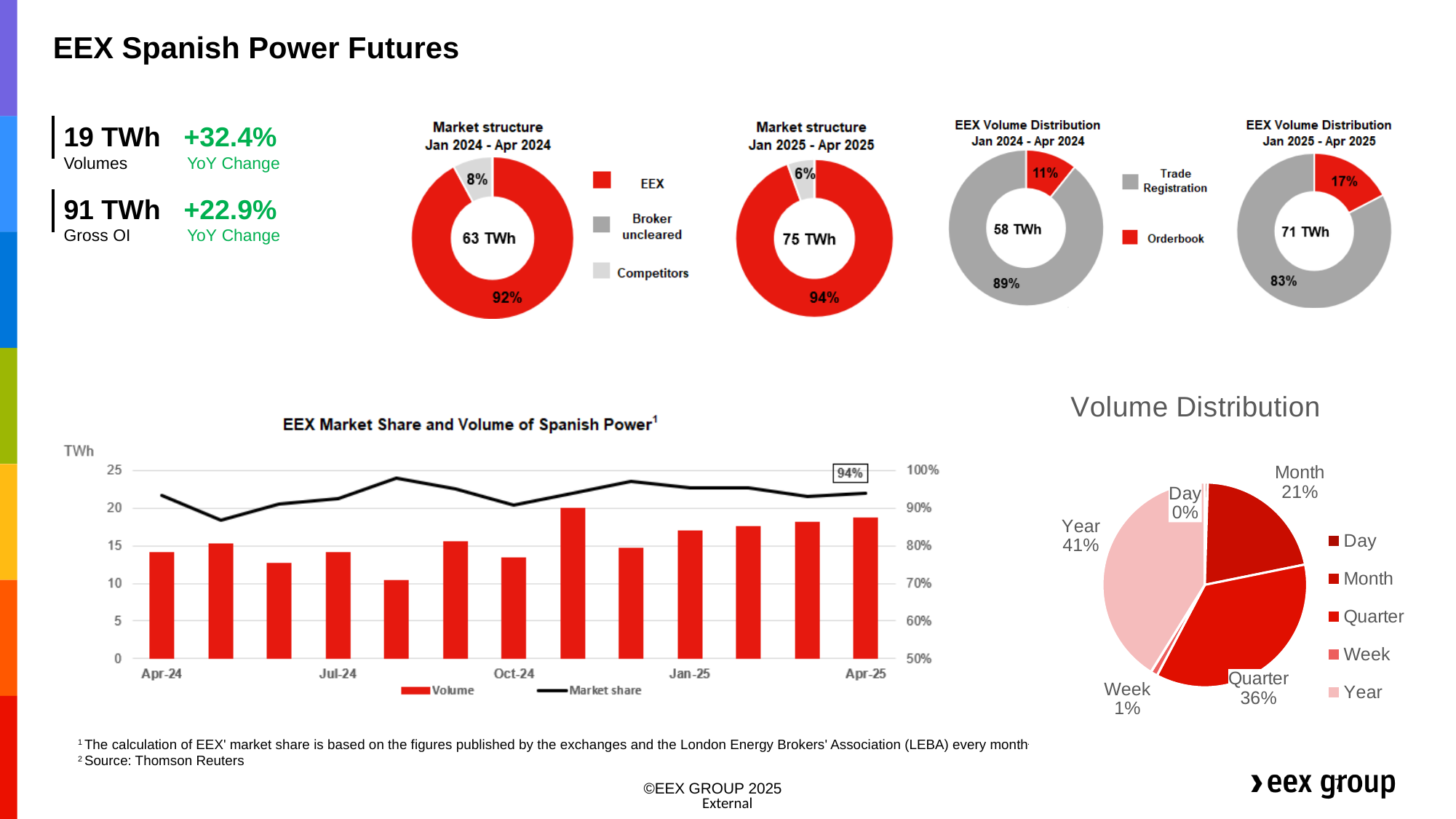
In the EEX Market Share and Volume of Spanish Power chart, is the volume bar for Apr-25 greater or less than 15 TWh? greater How many entries does the legend of the Volume Distribution pie chart list? 5 In the EEX Market Share and Volume of Spanish Power chart, is the volume bar for Oct-24 greater or less than 15 TWh? less In the EEX Market Share and Volume of Spanish Power chart, what market share value is labelled for Apr-25? 94% In the EEX Volume Distribution Jan 2024 - Apr 2024 donut chart, what share does Trade Registration hold? 89% In the Market structure Jan 2025 - Apr 2025 donut chart, what share does EEX hold? 94% In the EEX Volume Distribution Jan 2025 - Apr 2025 donut chart, what share does Orderbook hold? 17% What total volume is shown in the centre of the Market structure Jan 2024 - Apr 2024 donut chart? 63 TWh In the Volume Distribution pie chart, which category has the smallest share? Day In the Volume Distribution pie chart, which category has the largest share? Year In the Volume Distribution pie chart, what is the difference in percentage points between the Year and Quarter shares? 5% In the Volume Distribution pie chart, what share does Year account for? 41%